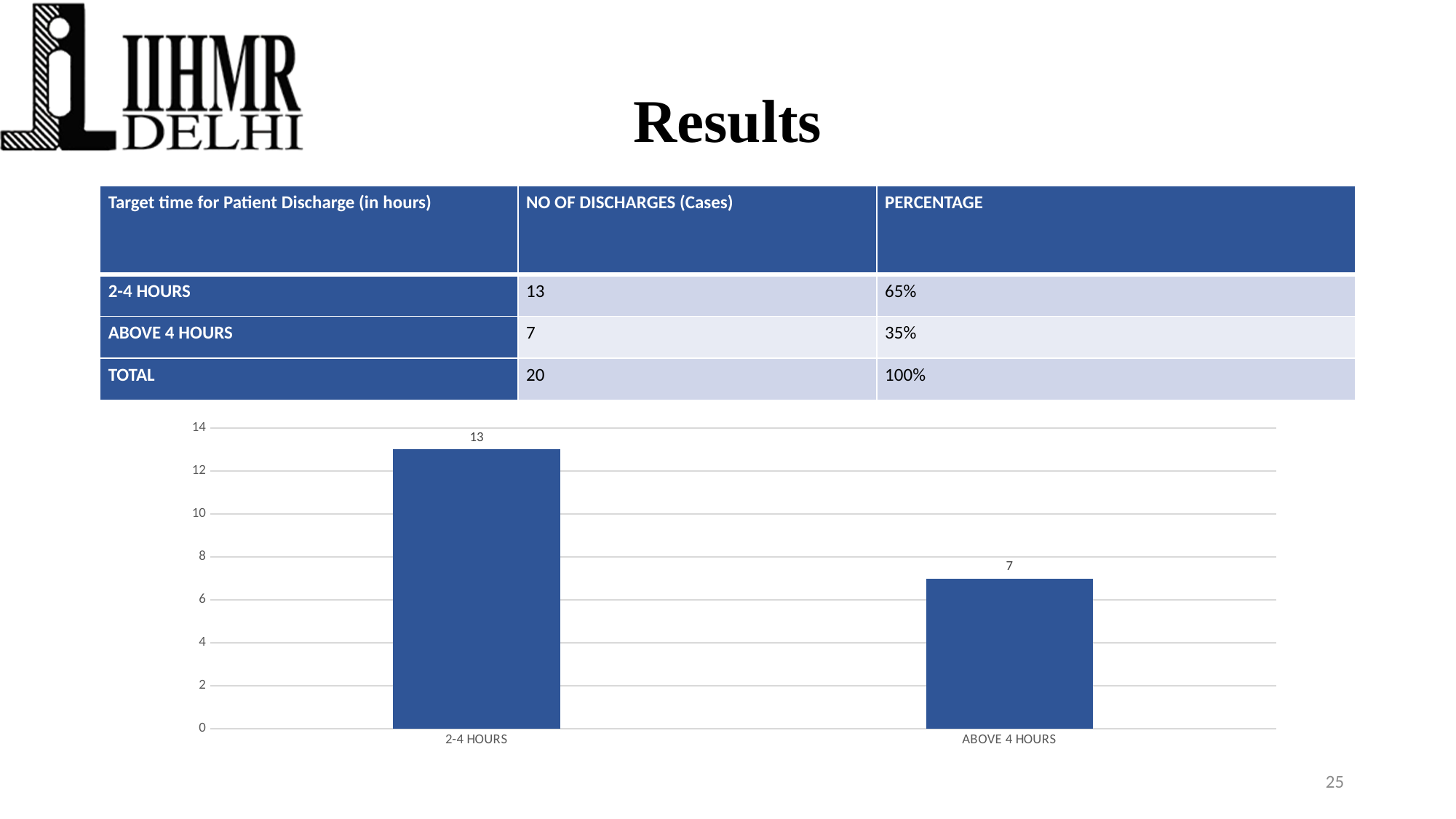
What is the value for ABOVE 4 HOURS in the bar chart? 7 Is the value for ABOVE 4 HOURS greater or less than 8? less What is the difference between the values for 2-4 HOURS and ABOVE 4 HOURS in the bar chart? 6 Which category has the lowest value in the bar chart? ABOVE 4 HOURS How many categories are shown in the bar chart? 2 Which is larger in the bar chart, the value for 2-4 HOURS or the value for ABOVE 4 HOURS? 2-4 HOURS What kind of chart is shown on the slide? bar chart What is the highest value shown on the vertical axis of the bar chart? 14 Is the value for 2-4 HOURS greater or less than 12? greater Which category has the highest value in the bar chart? 2-4 HOURS What is the total of the two bar values in the chart? 20 What is the value for 2-4 HOURS in the bar chart? 13